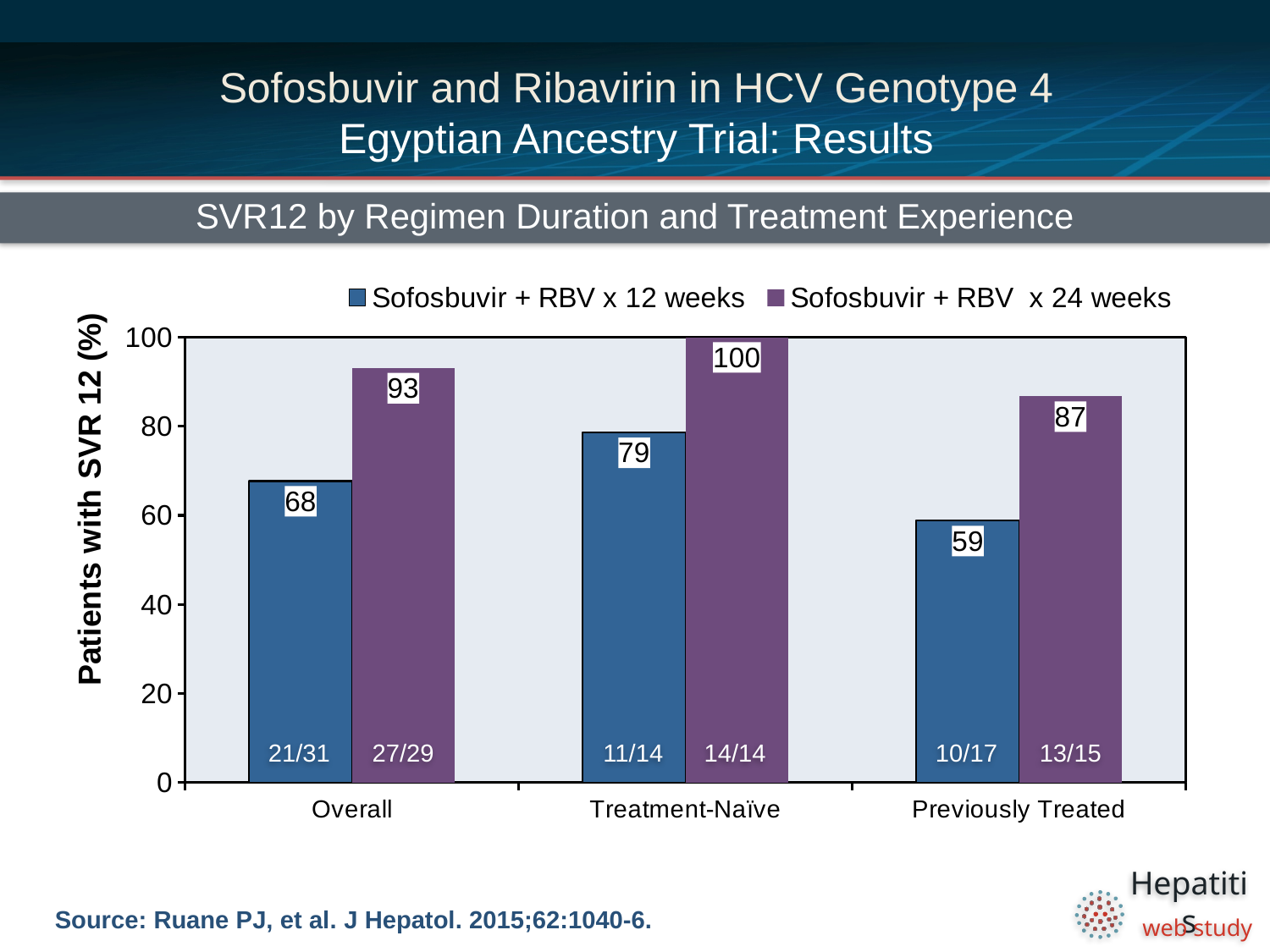
What is the SVR12 rate for Sofosbuvir + RBV x 24 weeks in the Previously Treated group? 87 What is the SVR12 rate for Sofosbuvir + RBV x 24 weeks in the Treatment-Naïve group? 100 Which patient group has the highest SVR12 rate for Sofosbuvir + RBV x 24 weeks? Treatment-Naïve In the Previously Treated group, which regimen has the higher SVR12 rate? Sofosbuvir + RBV x 24 weeks What kind of chart is shown on the slide? Bar chart What is the SVR12 rate for Sofosbuvir + RBV x 12 weeks in the Overall group? 68 Which patient group has the lowest SVR12 rate for Sofosbuvir + RBV x 12 weeks? Previously Treated What is the label of the y axis? Patients with SVR 12 (%) What is the difference between the 24-week and 12-week SVR12 rates in the Overall group? 25 How many patient groups are shown on the x axis? 3 What fraction of patients is shown for Sofosbuvir + RBV x 12 weeks in the Previously Treated group? 10/17 How many series does the legend list? 2